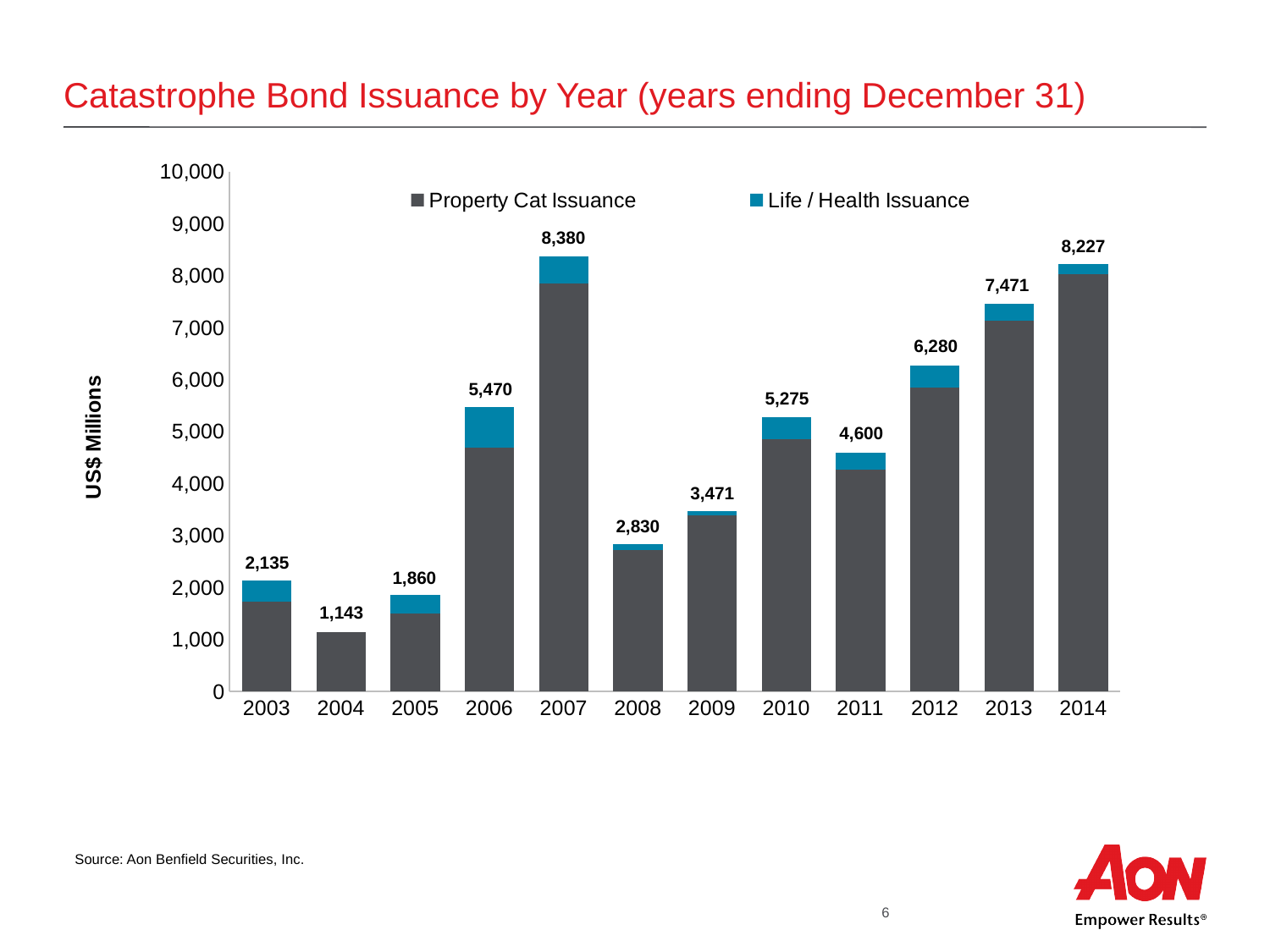
Which year has the lowest total catastrophe bond issuance? 2004 What is the difference between the total issuance in 2007 and in 2006? 2,910 What is the difference between the total issuance in 2014 and in 2013? 756 What kind of chart is shown on the slide? Stacked bar chart Is the Property Cat Issuance value for 2007 greater or less than 7,000? greater What is the total catastrophe bond issuance for 2004? 1,143 What is the total catastrophe bond issuance for 2011? 4,600 Which year has a larger total issuance, 2010 or 2012? 2012 How many series does the legend list? 2 Which year has the highest total catastrophe bond issuance? 2007 What is the total catastrophe bond issuance for 2007? 8,380 How many years are shown on the x axis of the chart? 12